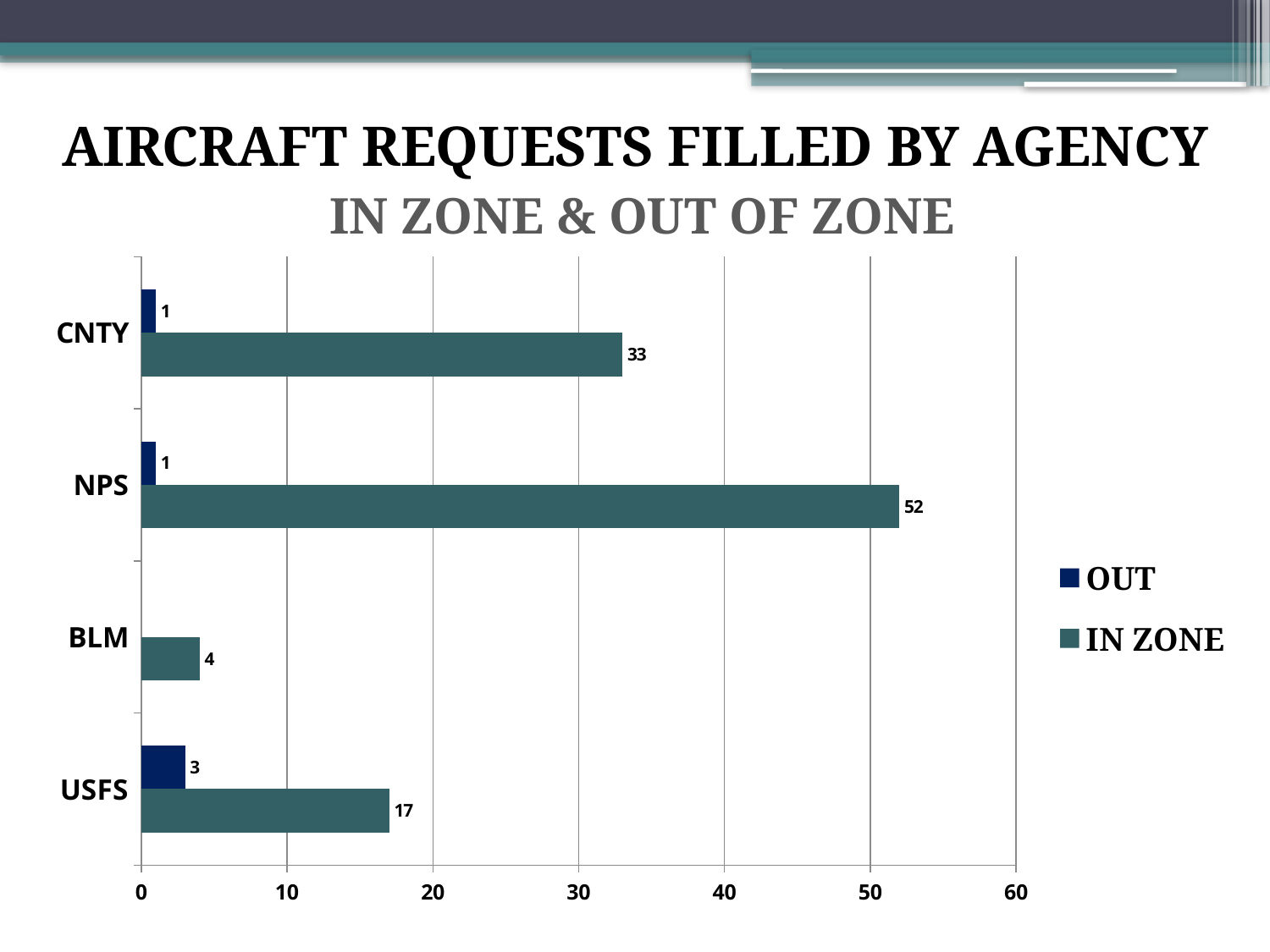
Which is larger, the IN ZONE value for USFS or the IN ZONE value for CNTY? CNTY What is the IN ZONE value for BLM? 4 What is the difference between the OUT values for USFS and NPS? 2 Which agency has the lowest IN ZONE value? BLM How many agencies are shown on the chart? 4 How many series does the legend list? 2 What is the IN ZONE value for NPS? 52 What kind of chart is shown on the slide? Bar chart What is the IN ZONE value for CNTY? 33 Which agency has the highest IN ZONE value? NPS What is the difference between the IN ZONE values for NPS and CNTY? 19 What is the OUT value for USFS? 3